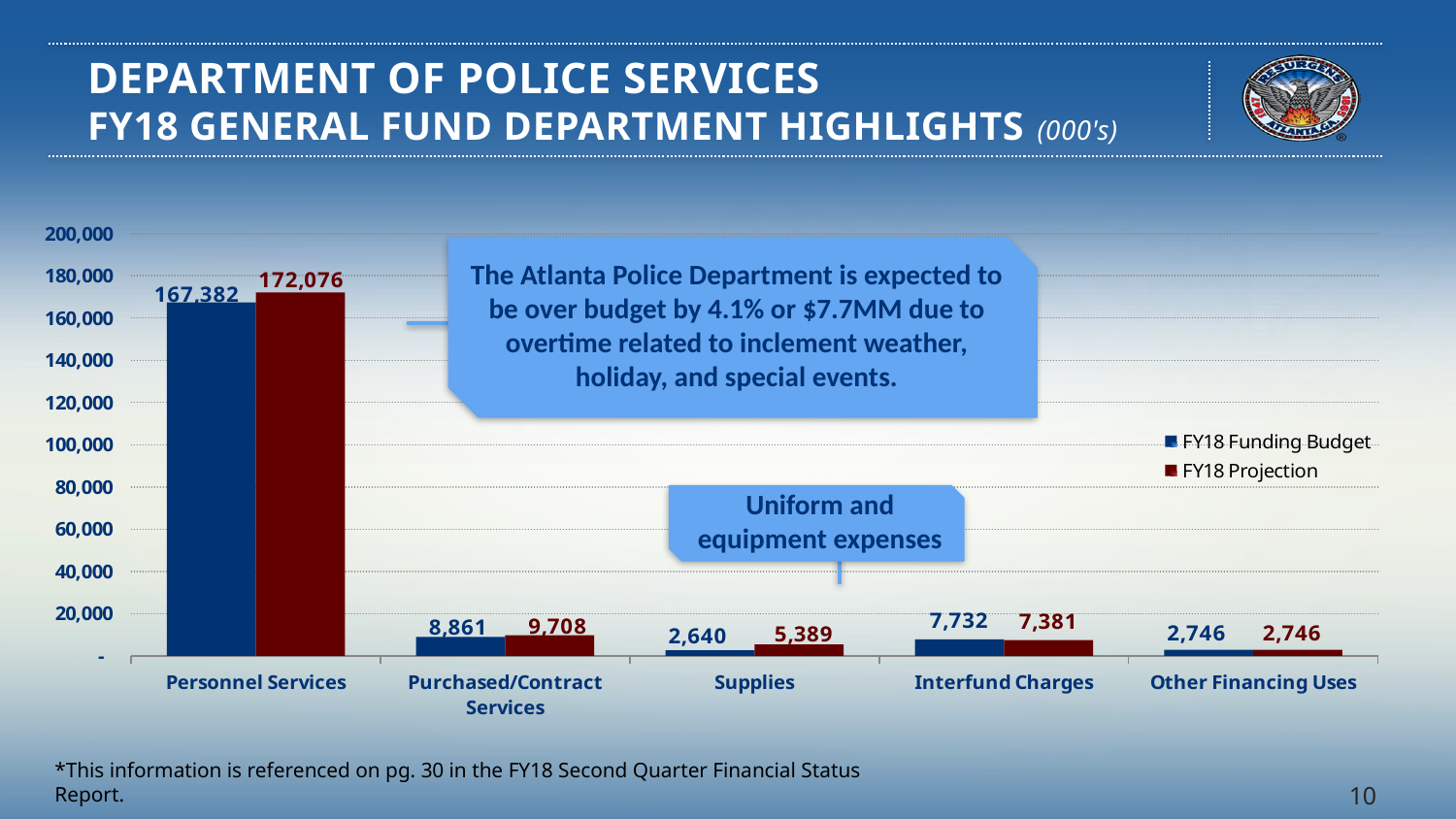
How many categories are shown on the x axis of the chart? 5 What kind of chart is shown on the slide? Bar chart Is the FY18 Projection value for Personnel Services greater or less than 160,000? greater What is the FY18 Projection value for Personnel Services? 172,076 What is the difference between the FY18 Projection and FY18 Funding Budget for Personnel Services? 4,694 What is the difference between the FY18 Projection and FY18 Funding Budget for Supplies? 2,749 What is the FY18 Projection value for Interfund Charges? 7,381 Which category has the lowest FY18 Funding Budget value? Supplies What is the FY18 Funding Budget value for Supplies? 2,640 For Interfund Charges, which is larger: the FY18 Funding Budget or the FY18 Projection? FY18 Funding Budget How many series does the chart legend list? 2 Which category has the highest FY18 Funding Budget value? Personnel Services